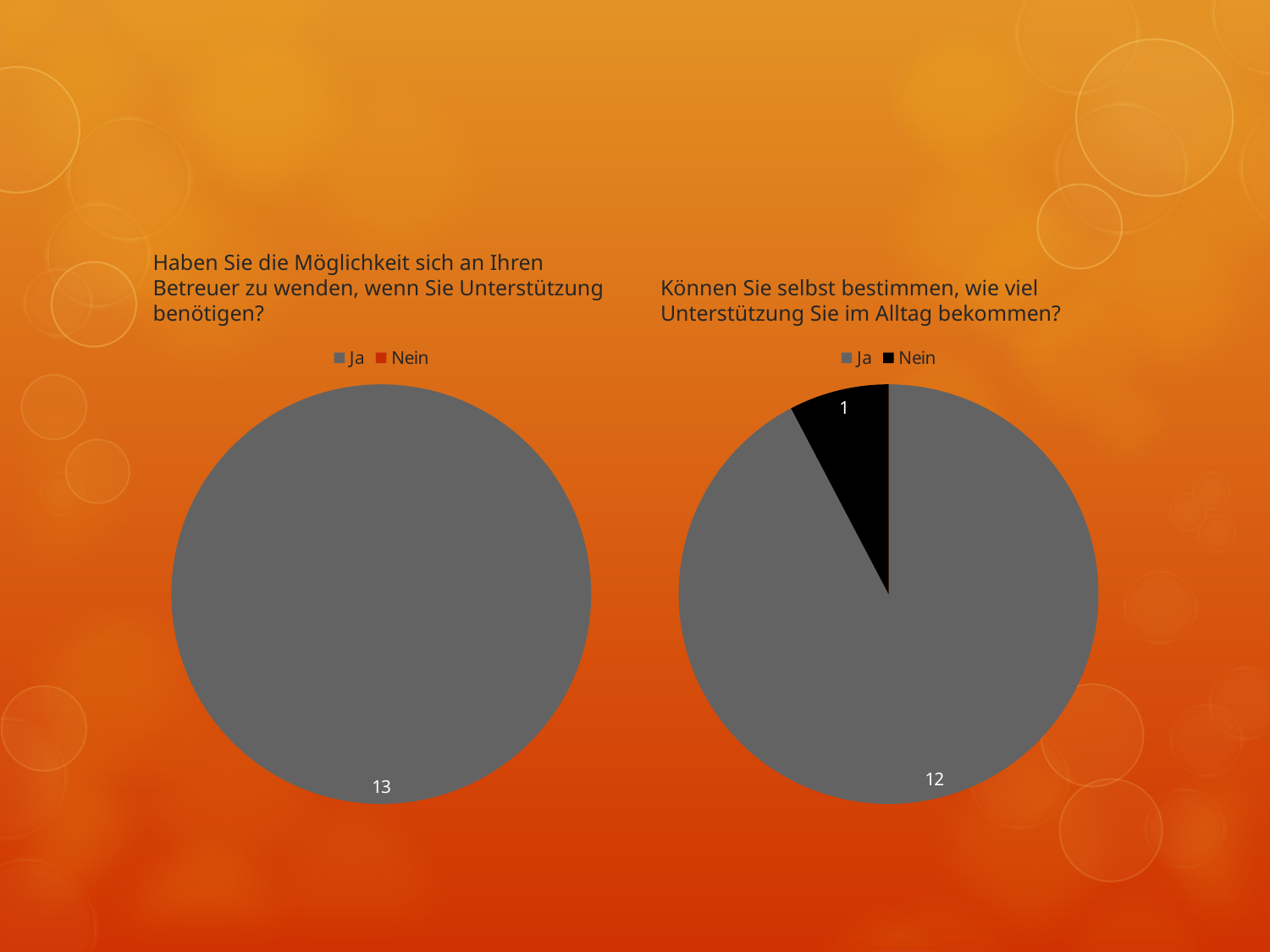
In the right chart ("Können Sie selbst bestimmen..."), what colour is the Nein slice? black In the right chart ("Können Sie selbst bestimmen..."), which category has the largest slice? Ja In the right chart ("Können Sie selbst bestimmen, wie viel Unterstützung Sie im Alltag bekommen?"), what value is shown for Ja? 12 In the right chart ("Können Sie selbst bestimmen..."), is the value for Ja larger or smaller than the value for Nein? larger In the right chart ("Können Sie selbst bestimmen..."), which category has the smallest slice? Nein In the left chart ("Haben Sie die Möglichkeit sich an Ihren Betreuer zu wenden..."), what value is shown for Ja? 13 What type of chart is the left chart ("Haben Sie die Möglichkeit...")? pie chart In the right chart ("Können Sie selbst bestimmen..."), what value is shown for Nein? 1 In the right chart ("Können Sie selbst bestimmen..."), what is the difference between the Ja and Nein values? 11 In the right chart ("Können Sie selbst bestimmen..."), what is the total of the Ja and Nein values? 13 What are the legend entries of the left chart ("Haben Sie die Möglichkeit...")? Ja, Nein How many entries does the legend of the right chart ("Können Sie selbst bestimmen...") list? 2